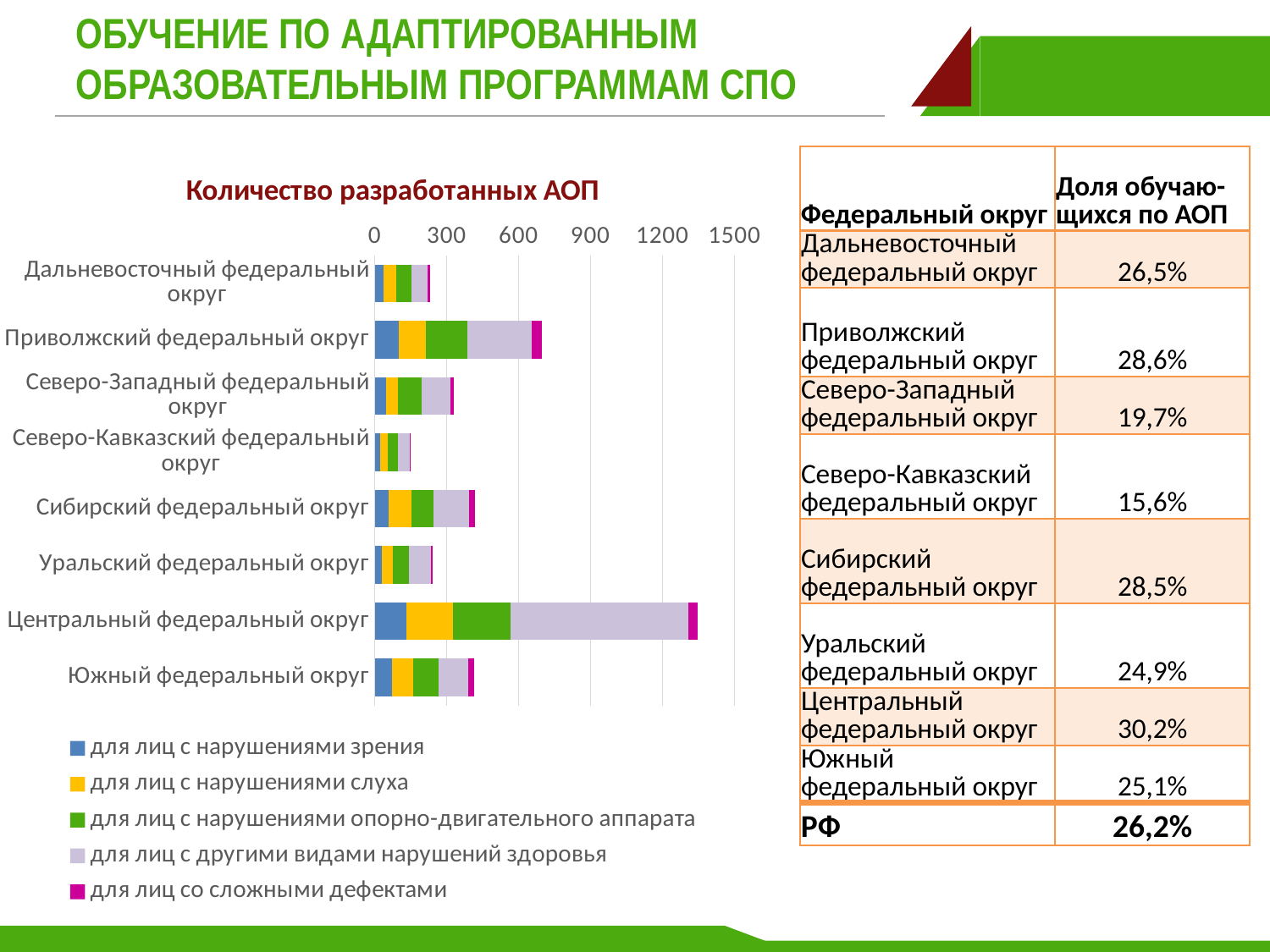
On the chart "Количество разработанных АОП", is the total for Приволжский федеральный округ greater or less than 600? greater What is the title of the bar chart on the slide? Количество разработанных АОП Which federal district has the longest total bar on the chart "Количество разработанных АОП"? Центральный федеральный округ On the chart "Количество разработанных АОП", is the total for Северо-Кавказский федеральный округ greater or less than 300? less How many federal districts are shown on the chart "Количество разработанных АОП"? 8 Which federal district has the shortest total bar on the chart "Количество разработанных АОП"? Северо-Кавказский федеральный округ On the chart "Количество разработанных АОП", is the total for Центральный федеральный округ greater or less than 1200? greater On the chart "Количество разработанных АОП", which has the larger total bar: Приволжский федеральный округ or Сибирский федеральный округ? Приволжский федеральный округ What kind of chart is "Количество разработанных АОП"? stacked bar chart How many series does the legend of the chart "Количество разработанных АОП" list? 5 On the chart "Количество разработанных АОП", which series is shown in green? для лиц с нарушениями опорно-двигательного аппарата